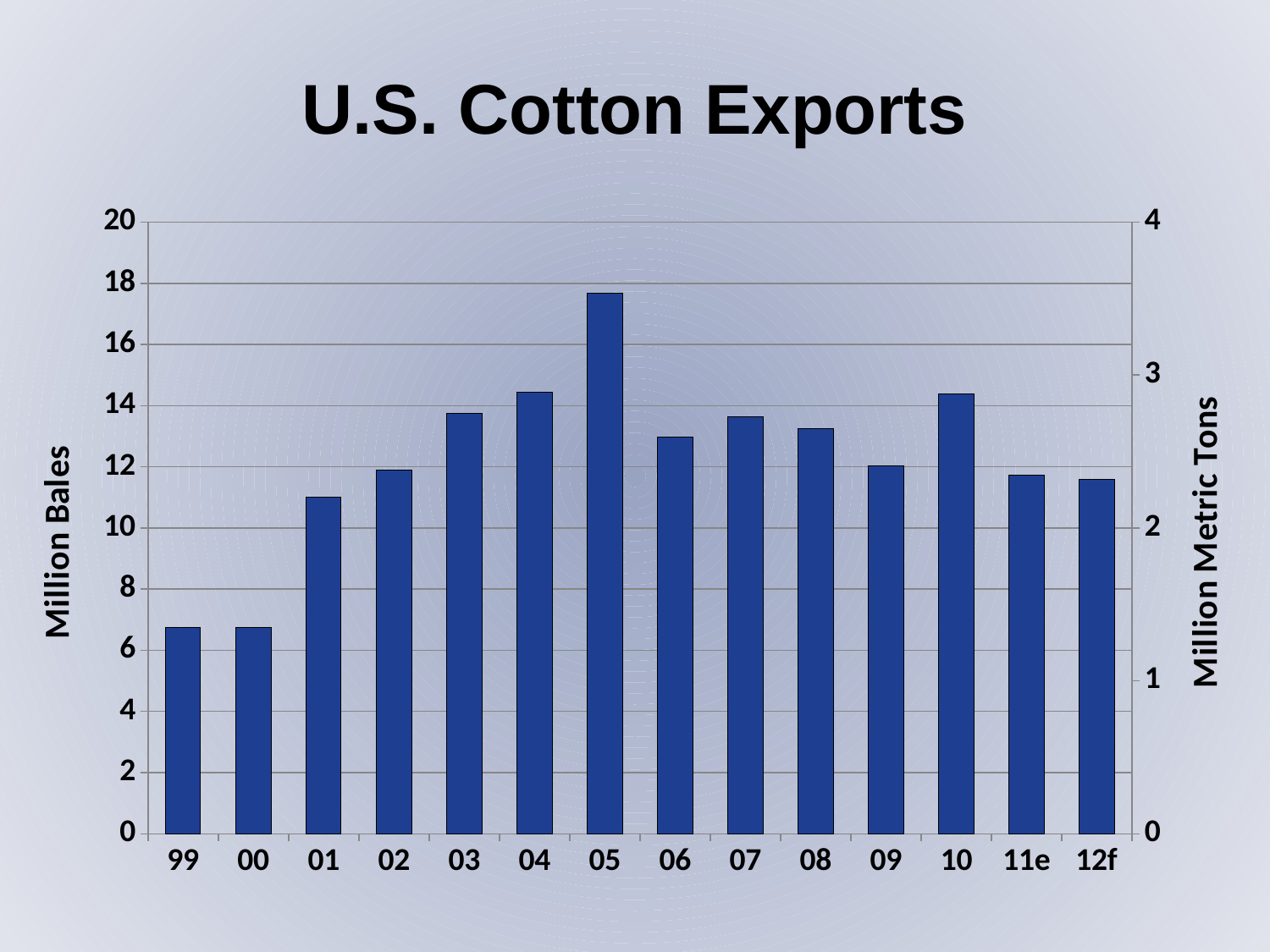
Which year has the larger export value, 00 or 01? 01 Which year has the larger export value, 05 or 06? 05 Is the value for 06 greater or less than 12 million bales? greater Is the value for 01 greater or less than 10 million bales? greater Is the value for 05 greater or less than 16 million bales? greater What is the title of the left vertical axis? Million Bales Which year has the highest U.S. cotton exports? 05 How many years (bars) are shown on the x axis of the U.S. Cotton Exports chart? 14 What type of chart is shown on the slide? bar chart Do U.S. cotton exports rise or fall from 99 to 05? rise